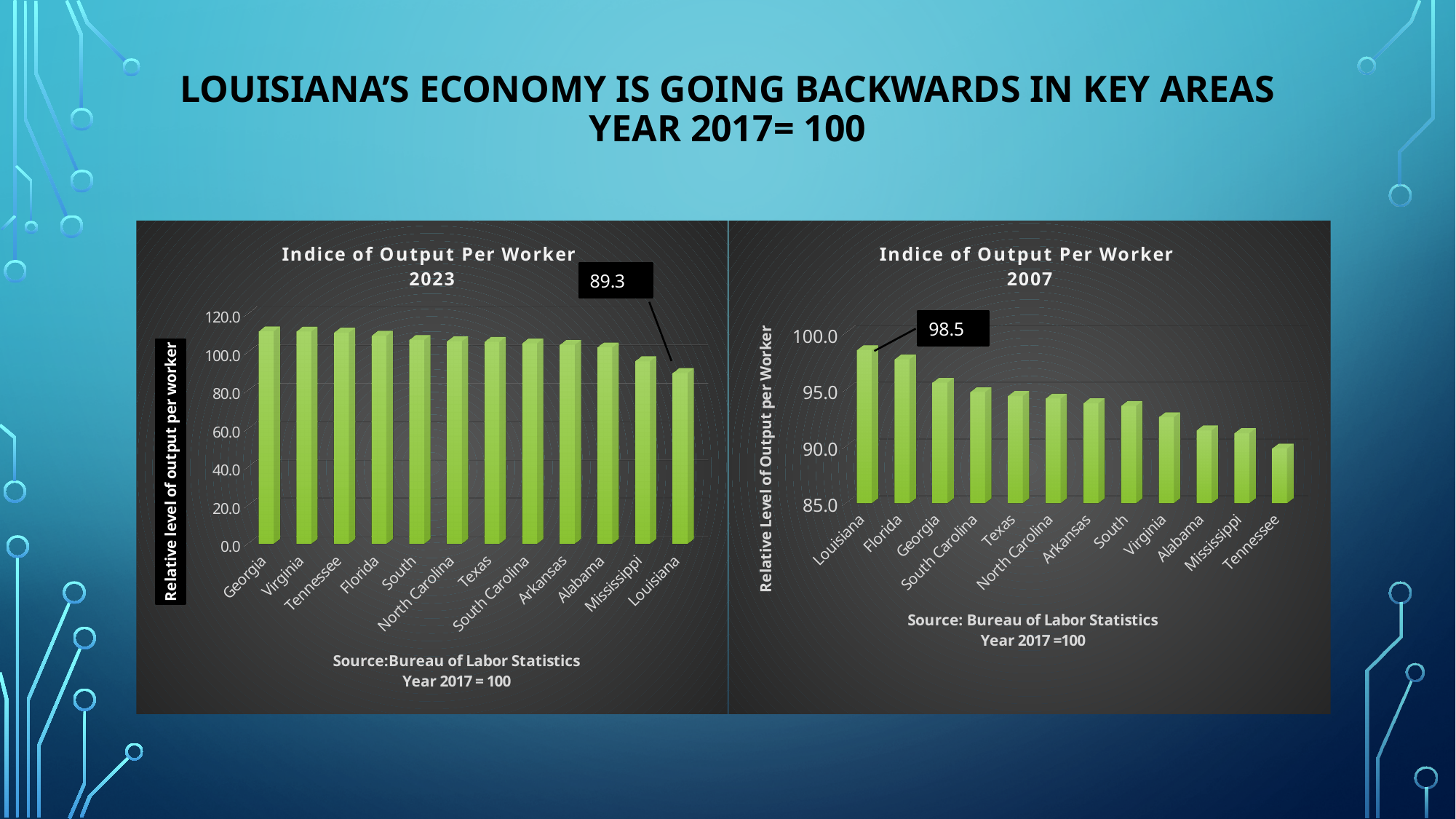
In the 'Indice of Output Per Worker 2023' chart, which state has the lowest value? Louisiana How much higher is Louisiana's labeled value in the 2007 chart than in the 2023 chart? 9.2 In the 'Indice of Output Per Worker 2007' chart, which category has the lowest value? Tennessee In the 'Indice of Output Per Worker 2007' chart, what is the value for Louisiana? 98.5 In the 'Indice of Output Per Worker 2023' chart, which is larger, the value for Georgia or the value for Louisiana? Georgia In the 'Indice of Output Per Worker 2007' chart, is the value for Tennessee greater or less than 95.0? less What is the y-axis title of the 'Indice of Output Per Worker 2007' chart? Relative Level of Output per Worker How many categories are shown in the 'Indice of Output Per Worker 2023' chart? 12 In the 'Indice of Output Per Worker 2023' chart, is the value for Mississippi greater or less than 100.0? less What kind of chart is the 'Indice of Output Per Worker 2007' chart? Bar chart In the 'Indice of Output Per Worker 2023' chart, do the values rise or fall from left to right? Fall In the 'Indice of Output Per Worker 2023' chart, what is the value for Louisiana? 89.3